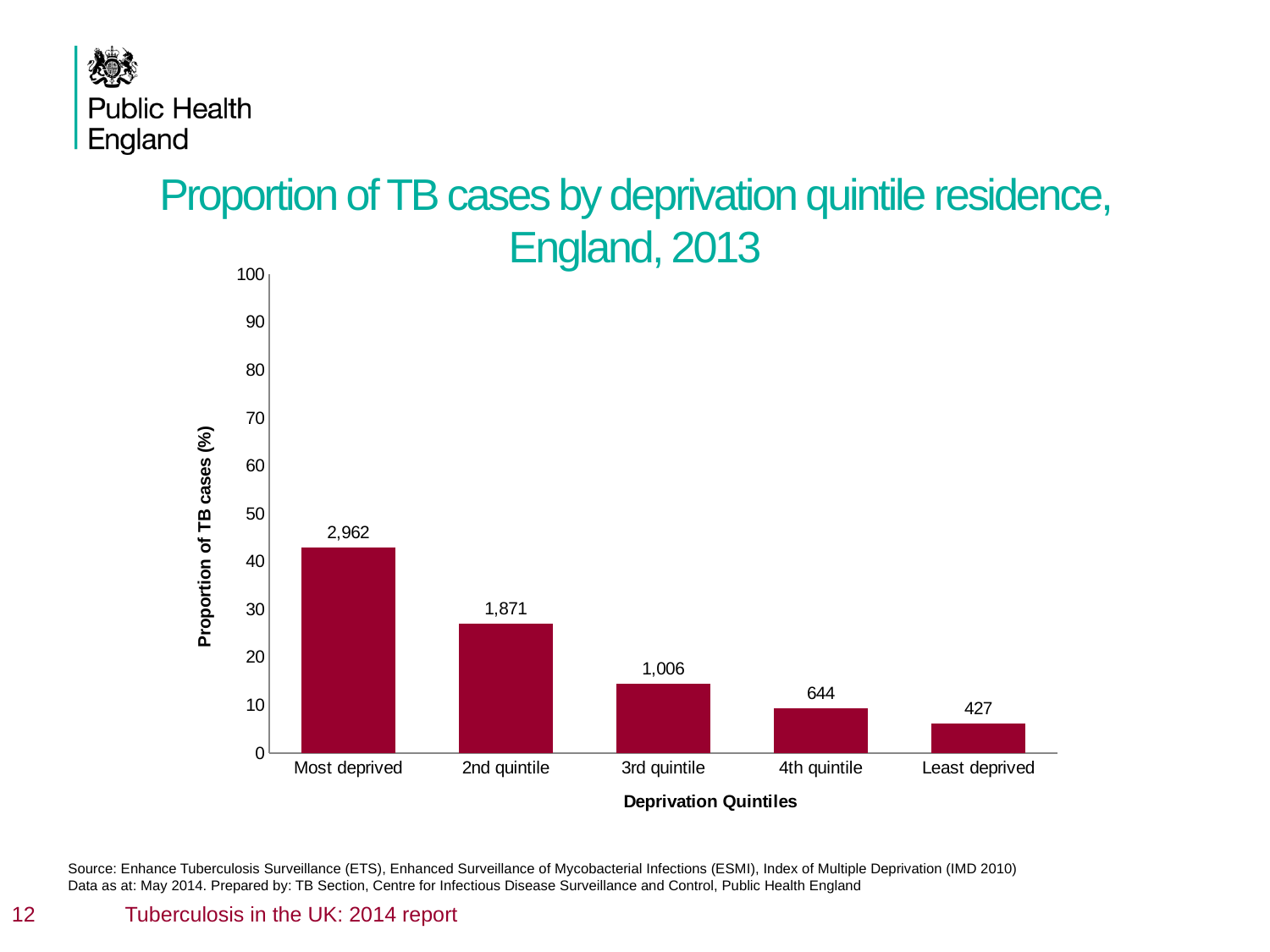
What is the difference between the data labels for 3rd quintile and 4th quintile? 362 What kind of chart is shown on the slide? Bar chart Is the proportion of TB cases for Most deprived greater or less than 40%? greater What is the difference between the data labels for Most deprived and 2nd quintile? 1,091 What is the data label shown on the bar for 2nd quintile? 1,871 What is the data label shown on the bar for Least deprived? 427 How many deprivation quintile categories are shown on the x axis? 5 Which deprivation quintile has the highest bar? Most deprived Which deprivation quintile has the lowest bar? Least deprived What is the data label shown on the bar for Most deprived? 2,962 Is the proportion of TB cases for 2nd quintile greater or less than 30%? less Which has a larger bar, 3rd quintile or 4th quintile? 3rd quintile